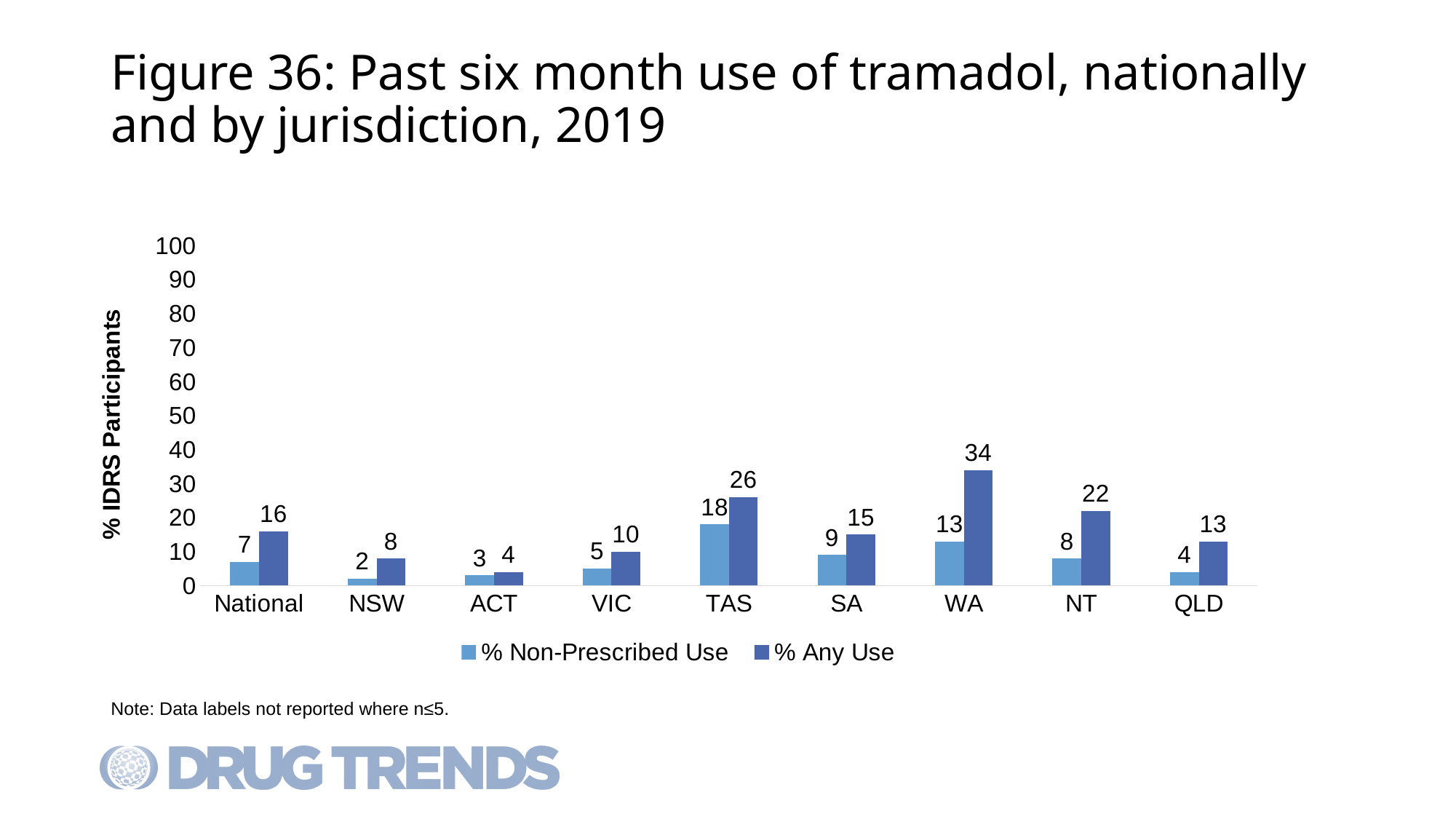
What is the % Any Use value for National? 16 What kind of chart is shown on the slide? bar chart Is the % Any Use value for WA greater or less than 30? greater How many series does the legend list? 2 What is the difference between % Any Use and % Non-Prescribed Use for NT? 14 Which is larger, the % Any Use value for TAS or for NT? TAS How many categories are shown on the x axis? 9 What is the % Non-Prescribed Use value for TAS? 18 Which jurisdiction has the lowest % Non-Prescribed Use value? NSW What is the % Any Use value for WA? 34 Which jurisdiction has the highest % Any Use value? WA What is the label of the y axis? % IDRS Participants